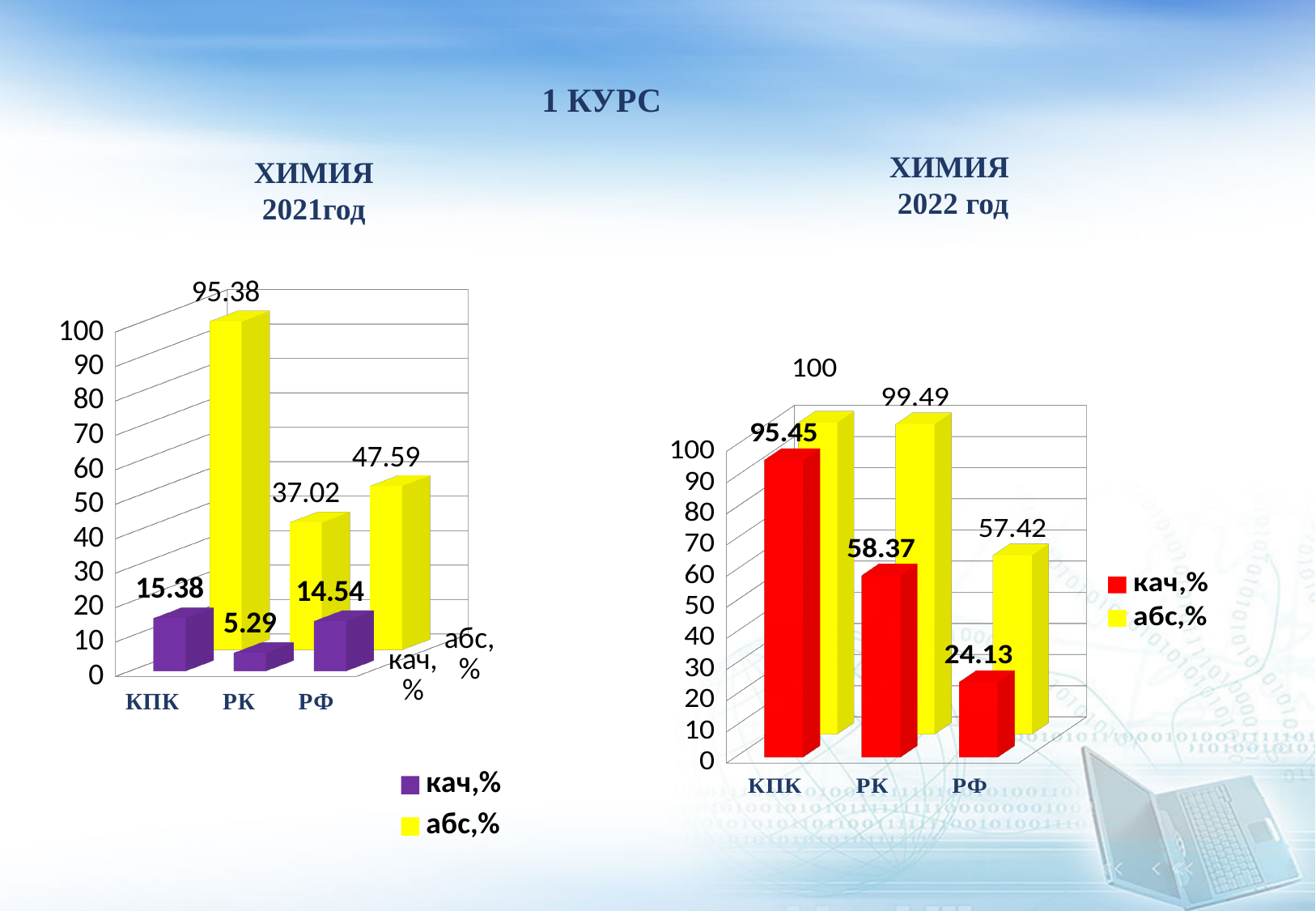
In the ХИМИЯ 2022 год chart, which category has the highest кач,% value? КПК How many series does the legend of the ХИМИЯ 2021год chart list? 2 In the ХИМИЯ 2022 год chart, what is the кач,% value for РФ? 24.13 In the ХИМИЯ 2021год chart, which category has the lowest кач,% value? РК In the ХИМИЯ 2022 год chart, what is the абс,% value for РК? 99.49 In the ХИМИЯ 2021год chart, which is larger: the абс,% value for РК or the абс,% value for РФ? РФ In the ХИМИЯ 2021год chart, what is the кач,% value for РК? 5.29 In the ХИМИЯ 2021год chart, what is the абс,% value for КПК? 95.38 In the ХИМИЯ 2022 год chart, what colour are the кач,% bars? Red What type of chart is the ХИМИЯ 2022 год chart? Bar chart How many categories are shown on the x axis of the ХИМИЯ 2022 год chart? 3 In the ХИМИЯ 2022 год chart, what is the difference between the абс,% and кач,% values for РФ? 33.29